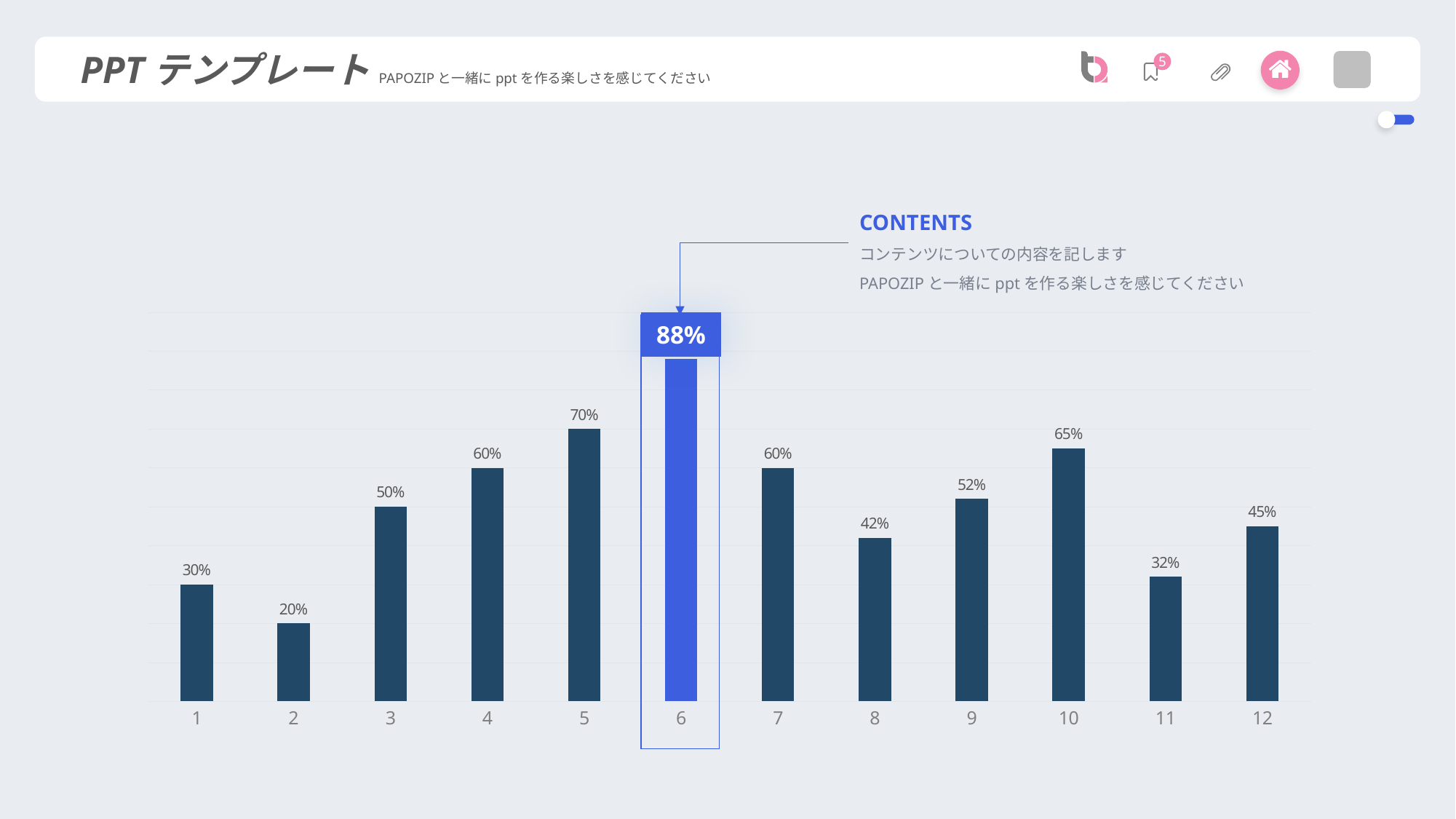
How many categories are shown on the x axis? 12 What is the difference between the values for category 9 and category 8? 10% What is the difference between the values for category 6 and category 5? 18% Which bar is highlighted in a different colour from the others? 6 Which category has the lowest value? 2 Do the values rise or fall from category 1 to category 6? rise What kind of chart is shown on the slide? bar chart What is the value for category 2? 20% Which category has the highest value? 6 Which is larger, the value for category 11 or the value for category 12? 12 What is the value for category 6? 88% What is the value for category 10? 65%